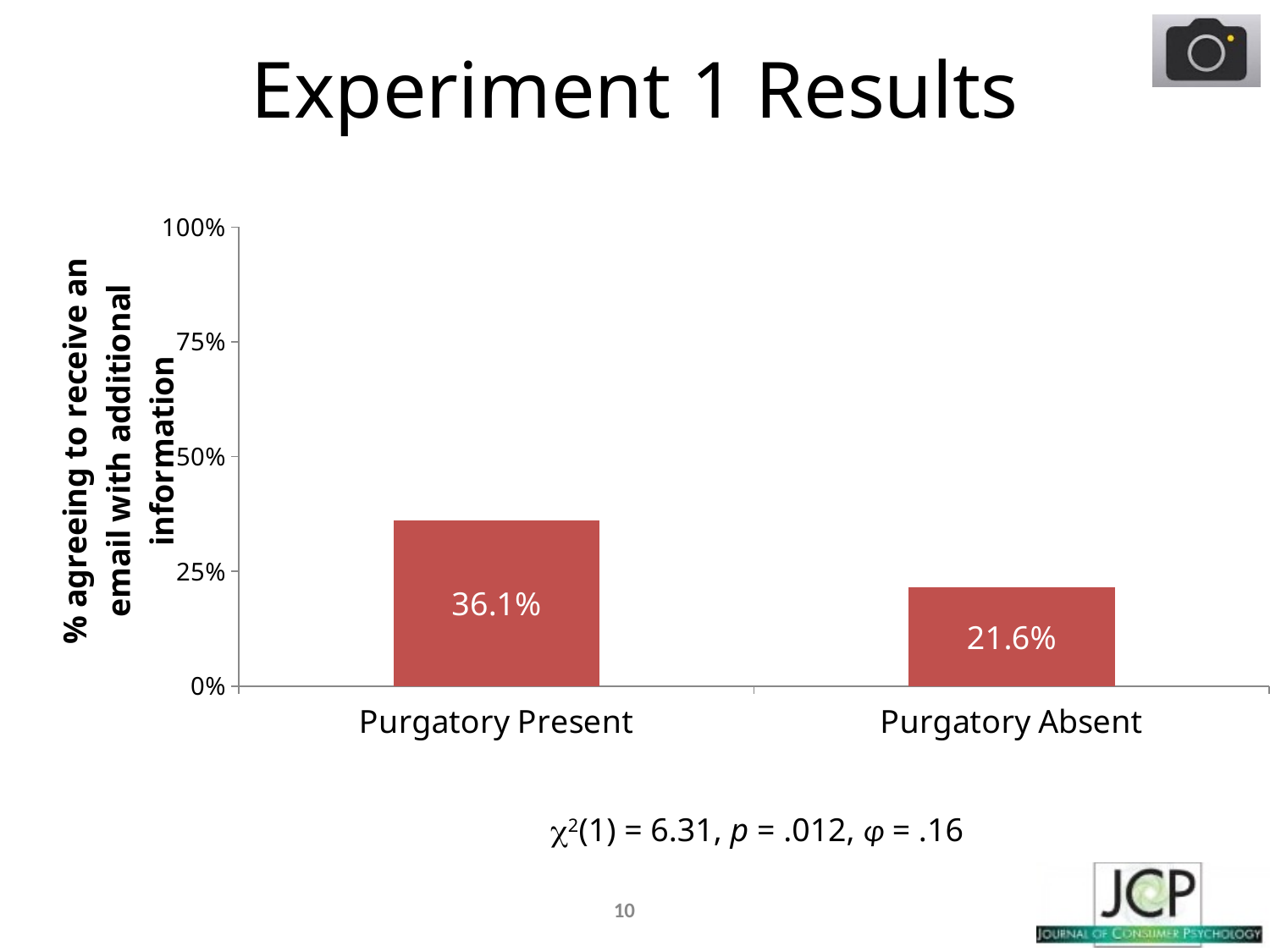
Which category has the lowest value? Purgatory Absent What is the label of the y axis? % agreeing to receive an email with additional information Which category has the highest value? Purgatory Present What kind of chart is shown on the slide? bar chart What is the difference between the values for Purgatory Present and Purgatory Absent? 14.5% Which is larger, the value for Purgatory Present or Purgatory Absent? Purgatory Present What is the title of the slide containing the chart? Experiment 1 Results What is the value for Purgatory Absent? 21.6% Is the value for Purgatory Present greater or less than 50%? less How many categories are shown on the x axis? 2 Is the value for Purgatory Absent greater or less than 25%? less What is the value for Purgatory Present? 36.1%